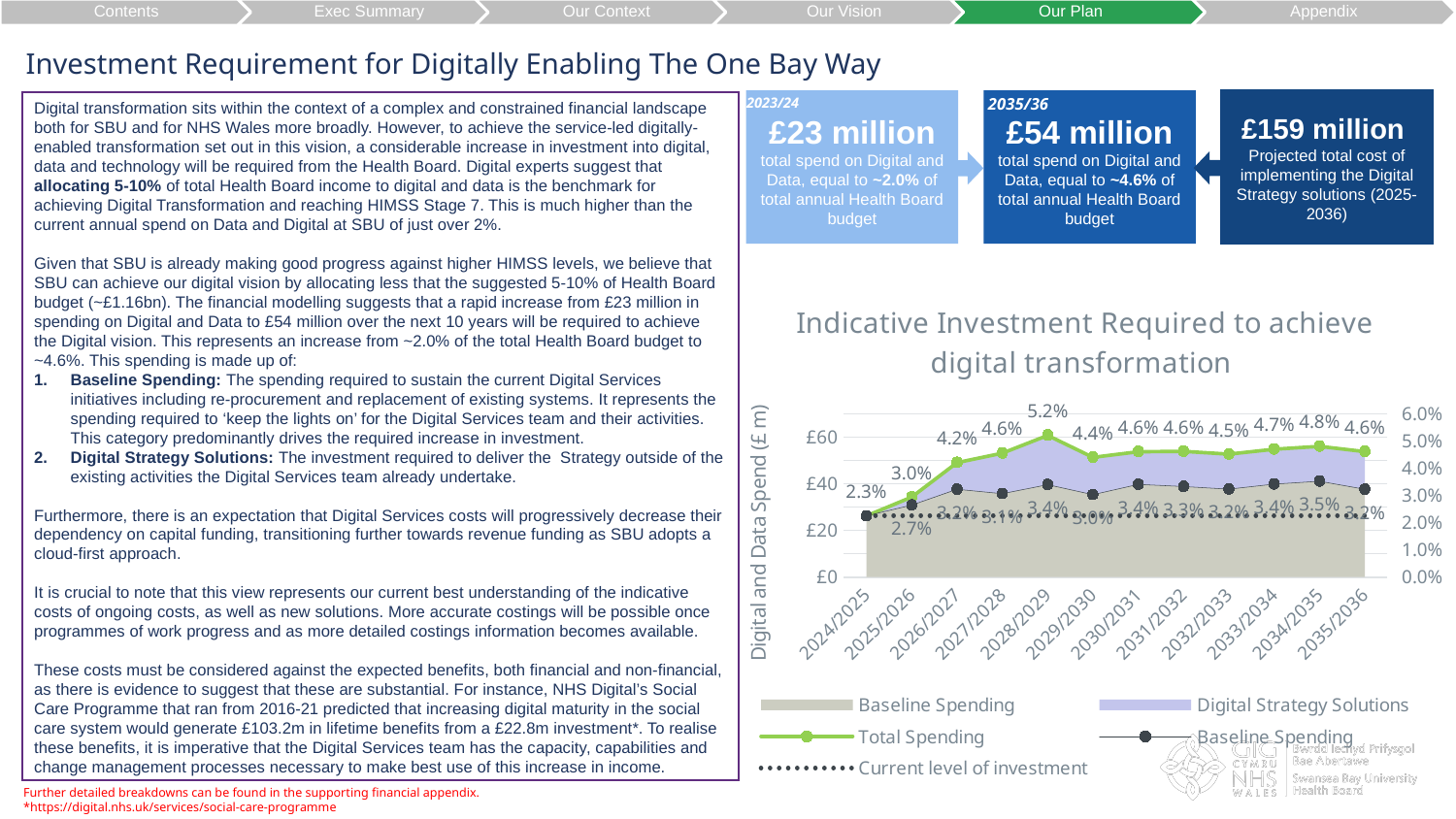
What is the Total Spending percentage for 2028/2029? 5.2% What is the difference between Total Spending and Baseline Spending percentages in 2035/2036? 1.4 percentage points How many entries does the chart's legend list? 5 In which year is the Total Spending percentage lowest? 2024/2025 What is the title of the chart on the right of the slide? Indicative Investment Required to achieve digital transformation In which year is the Total Spending percentage highest? 2028/2029 What is the Baseline Spending percentage for 2034/2035? 3.5% Which year has the higher Total Spending percentage, 2026/2027 or 2027/2028? 2027/2028 By how many percentage points does Total Spending fall from 2028/2029 to 2029/2030? 0.8 percentage points Does the Total Spending percentage rise or fall from 2024/2025 to 2028/2029? Rise How many financial years are shown along the x axis of the chart? 12 What is the Baseline Spending percentage for 2025/2026? 2.7%